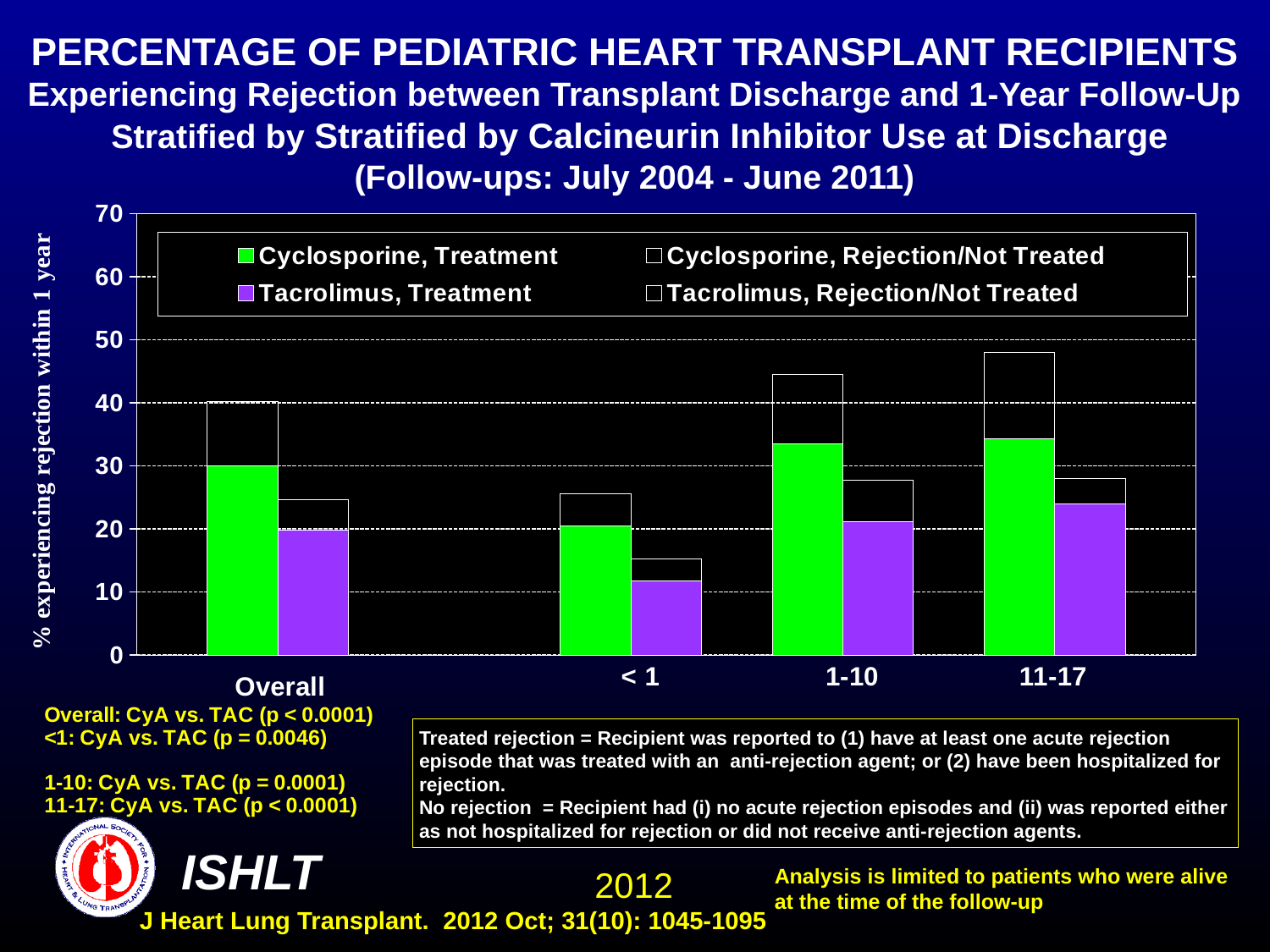
How many categories are shown along the x axis? 4 What is the label of the y axis? % experiencing rejection within 1 year How many series does the legend list? 4 For the Overall group, which total bar is taller, Cyclosporine or Tacrolimus? Cyclosporine Which age group has the tallest total Cyclosporine bar? 11-17 Is the Tacrolimus, Treatment value for the 11-17 age group greater or less than 20? greater Which age group has the shortest total Tacrolimus bar? < 1 Is the total height of the Tacrolimus bar for the < 1 age group greater or less than 20? less What colour represents the Cyclosporine, Treatment series? green What kind of chart is shown on the slide? bar chart Is the total height of the Cyclosporine bar for the Overall group greater or less than 30? greater